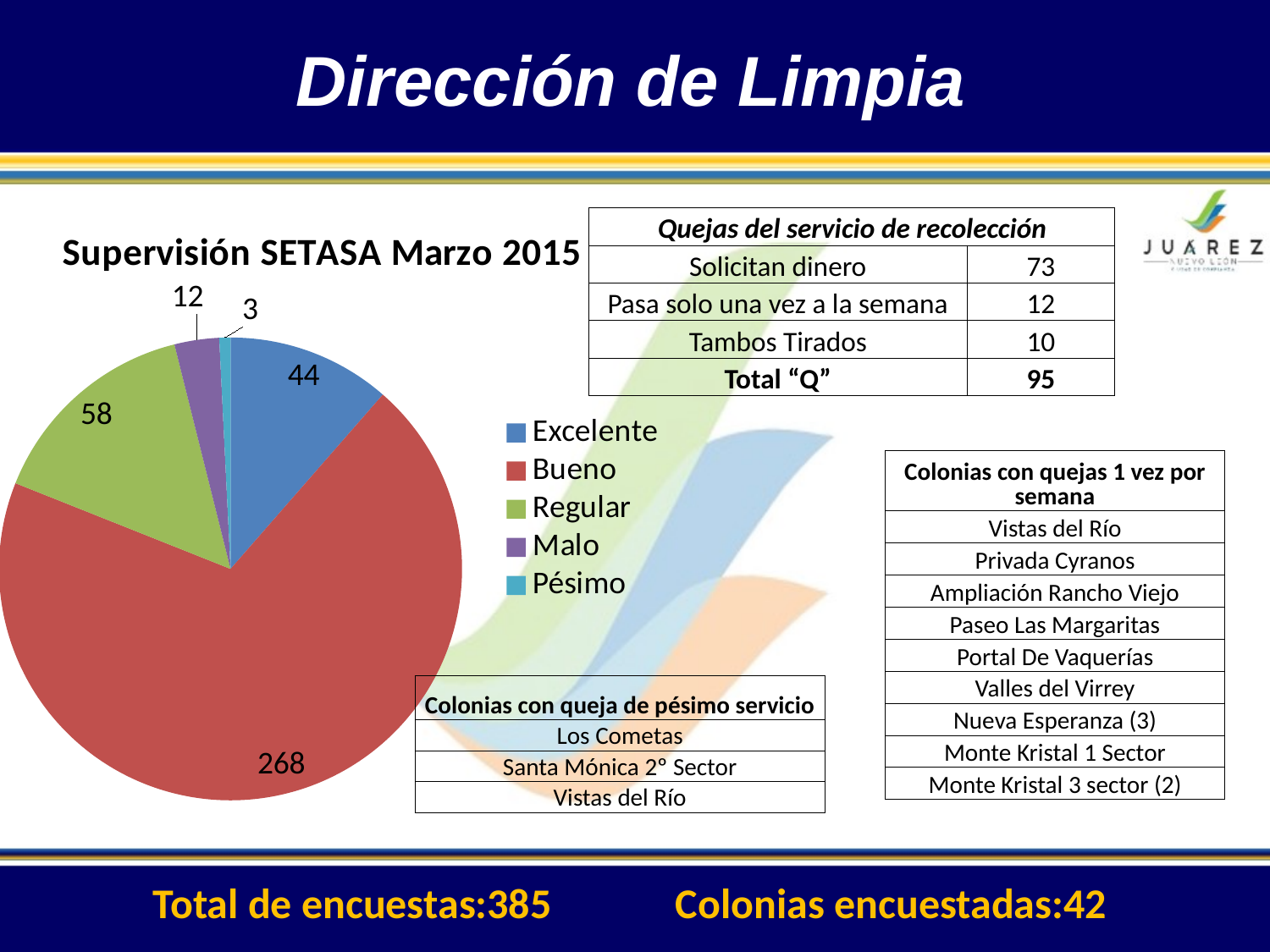
What is the value for Regular in the pie chart? 58 What is the title of the chart? Supervisión SETASA Marzo 2015 Which is larger, the value for Malo or the value for Excelente? Excelente Which category has the largest slice in the pie chart? Bueno What type of chart is shown on the slide? pie chart What is the total of all slices in the pie chart? 385 What is the difference between the values for Regular and Excelente? 14 What is the value for Pésimo in the pie chart? 3 How many categories does the legend of the pie chart list? 5 What is the value for Excelente in the pie chart? 44 Which category has the smallest slice in the pie chart? Pésimo What is the value for Bueno in the pie chart? 268